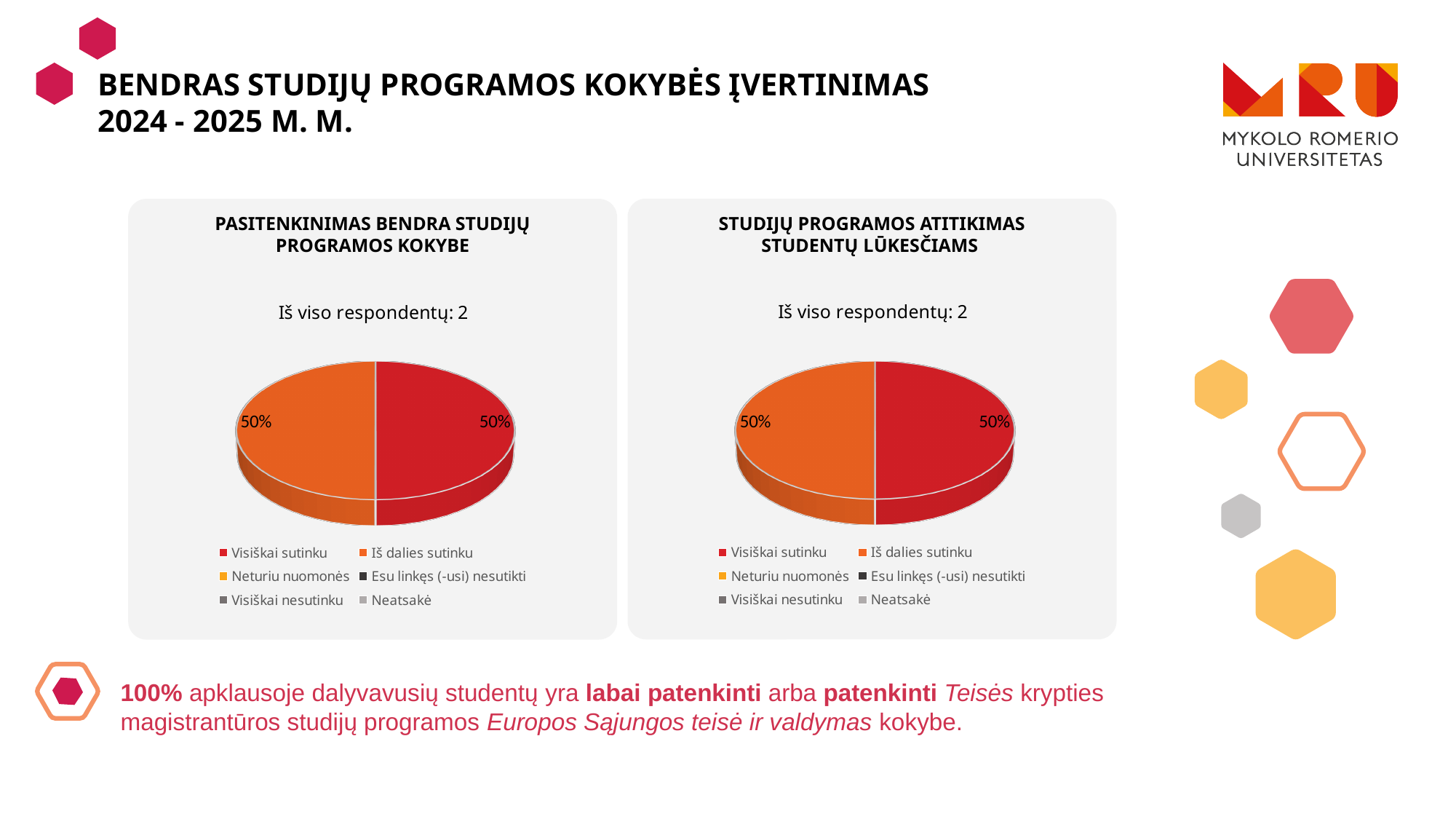
How many slices are shown in the 'Studijų programos atitikimas studentų lūkesčiams' pie chart? 2 How many entries does the legend of the 'Pasitenkinimas bendra studijų programos kokybe' chart list? 6 In the 'Studijų programos atitikimas studentų lūkesčiams' chart, what is the value for 'Visiškai sutinku'? 50% How many respondents in total are reported for the 'Studijų programos atitikimas studentų lūkesčiams' chart? 2 In the 'Pasitenkinimas bendra studijų programos kokybe' chart, what is the combined share of 'Visiškai sutinku' and 'Iš dalies sutinku'? 100% How many slices are shown in the 'Pasitenkinimas bendra studijų programos kokybe' pie chart? 2 What kind of chart is used in the 'Pasitenkinimas bendra studijų programos kokybe' panel? pie chart In the 'Studijų programos atitikimas studentų lūkesčiams' chart, what share of the pie is 'Iš dalies sutinku'? 50% In the 'Pasitenkinimas bendra studijų programos kokybe' chart, what share of the pie is 'Visiškai sutinku'? 50% In the 'Studijų programos atitikimas studentų lūkesčiams' chart, what is the difference between the 'Visiškai sutinku' and 'Iš dalies sutinku' shares? 0% In the 'Pasitenkinimas bendra studijų programos kokybe' chart, which colour represents 'Visiškai sutinku'? red In the 'Pasitenkinimas bendra studijų programos kokybe' chart, what is the value for 'Iš dalies sutinku'? 50%